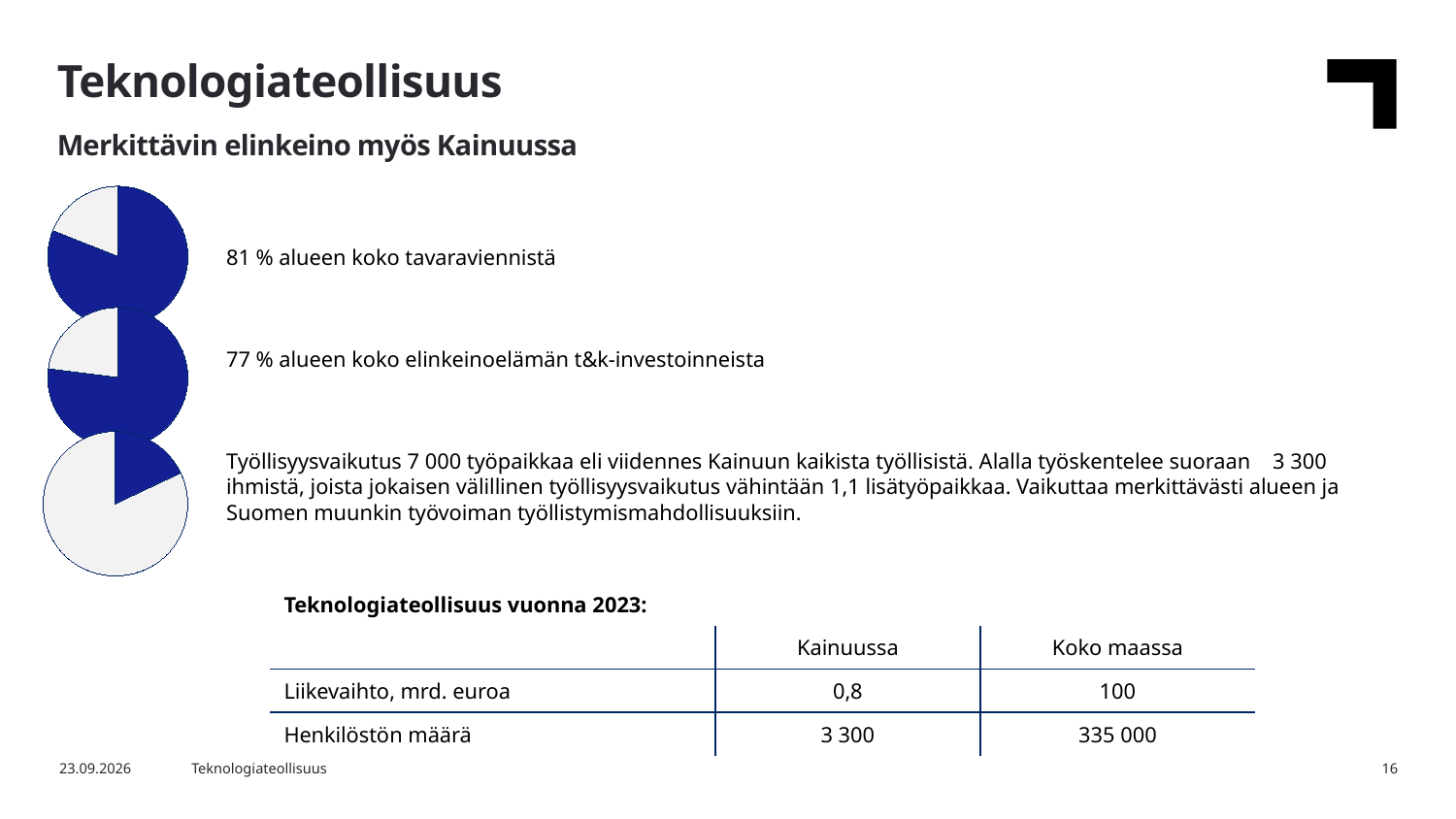
In the middle pie chart, what share does the dark blue slice represent according to the text next to it? 77 % What kind of charts are the three charts on the left side of the slide? Pie charts What does the top pie chart represent, according to the text beside it? 81 % alueen koko tavaraviennistä Which pie chart has the largest dark blue slice: the top, middle or bottom one? Top What colour is the highlighted slice in each of the pie charts? Dark blue How many slices does each pie chart on the slide have? 2 How many pie charts are shown on the slide? 3 Which pie chart has the smallest dark blue slice: the top, middle or bottom one? Bottom In the top pie chart, what share does the dark blue slice represent according to the text next to it? 81 % Is the dark blue slice in the top pie chart greater or less than 50% of the pie? greater Is the dark blue slice larger in the top pie chart or in the middle pie chart? Top pie chart Is the dark blue slice in the bottom pie chart greater or less than 50% of the pie? less